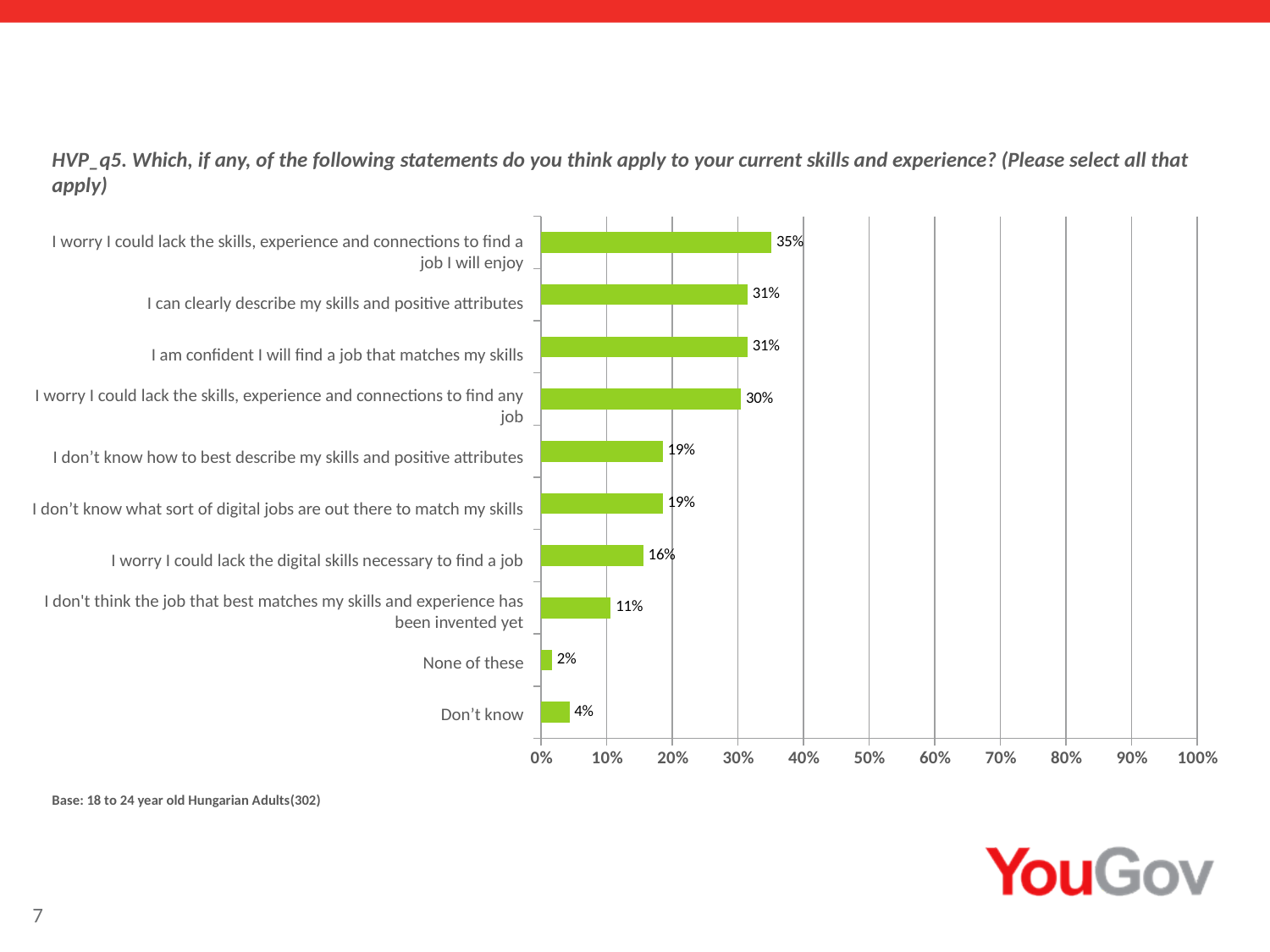
What is the value for "I worry I could lack the digital skills necessary to find a job"? 16% Which is larger: "I can clearly describe my skills and positive attributes" or "I don't know how to best describe my skills and positive attributes"? I can clearly describe my skills and positive attributes Which category has the lowest value? None of these Is the value for "I am confident I will find a job that matches my skills" greater or less than 40%? less How many categories are shown in the chart? 10 What percentage selected "I don't think the job that best matches my skills and experience has been invented yet"? 11% What type of chart is shown on the slide? Bar chart What is the value for "Don't know"? 4% What is the difference between "I worry I could lack the skills, experience and connections to find a job I will enjoy" and "I worry I could lack the skills, experience and connections to find any job"? 5% What percentage of respondents said "I worry I could lack the skills, experience and connections to find a job I will enjoy"? 35% Which statement has the highest percentage? I worry I could lack the skills, experience and connections to find a job I will enjoy What is the base (sample) described below the chart? 18 to 24 year old Hungarian Adults(302)